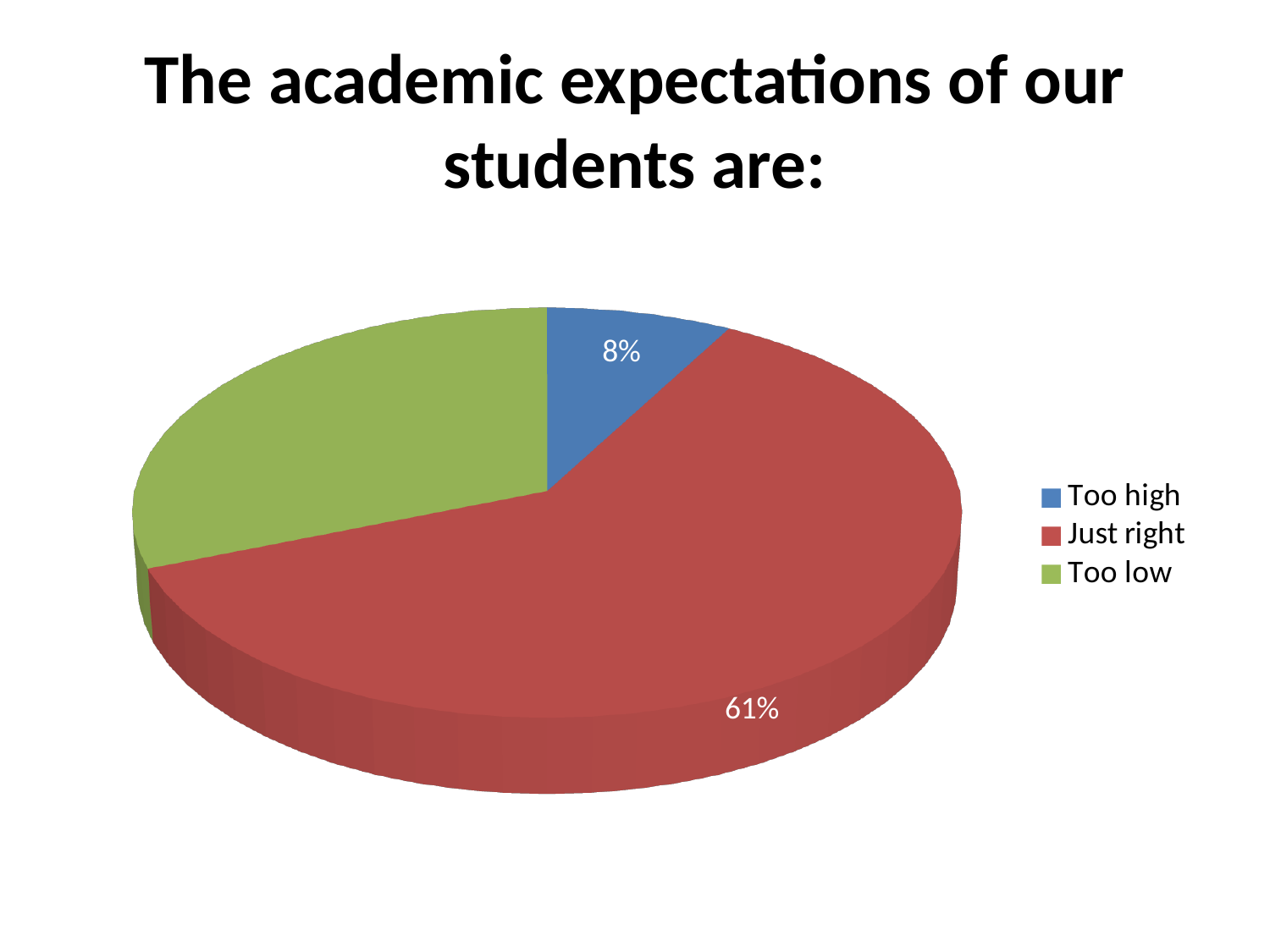
Which slice is larger, "Just right" or "Too low"? Just right Which category has the largest slice of the pie? Just right What colour is the "Just right" slice? red What is the title of the slide? The academic expectations of our students are: What is the difference in percentage points between the "Just right" and "Too high" slices? 53% Which category has the smallest slice of the pie? Too high Which slice is larger, "Too low" or "Too high"? Too low How many categories does the pie chart show? 3 What kind of chart is shown on the slide? pie chart What percentage of respondents said the academic expectations are "Just right"? 61% What percentage of respondents said the academic expectations are "Too high"? 8% What share of the pie does the "Just right" slice represent? 61%